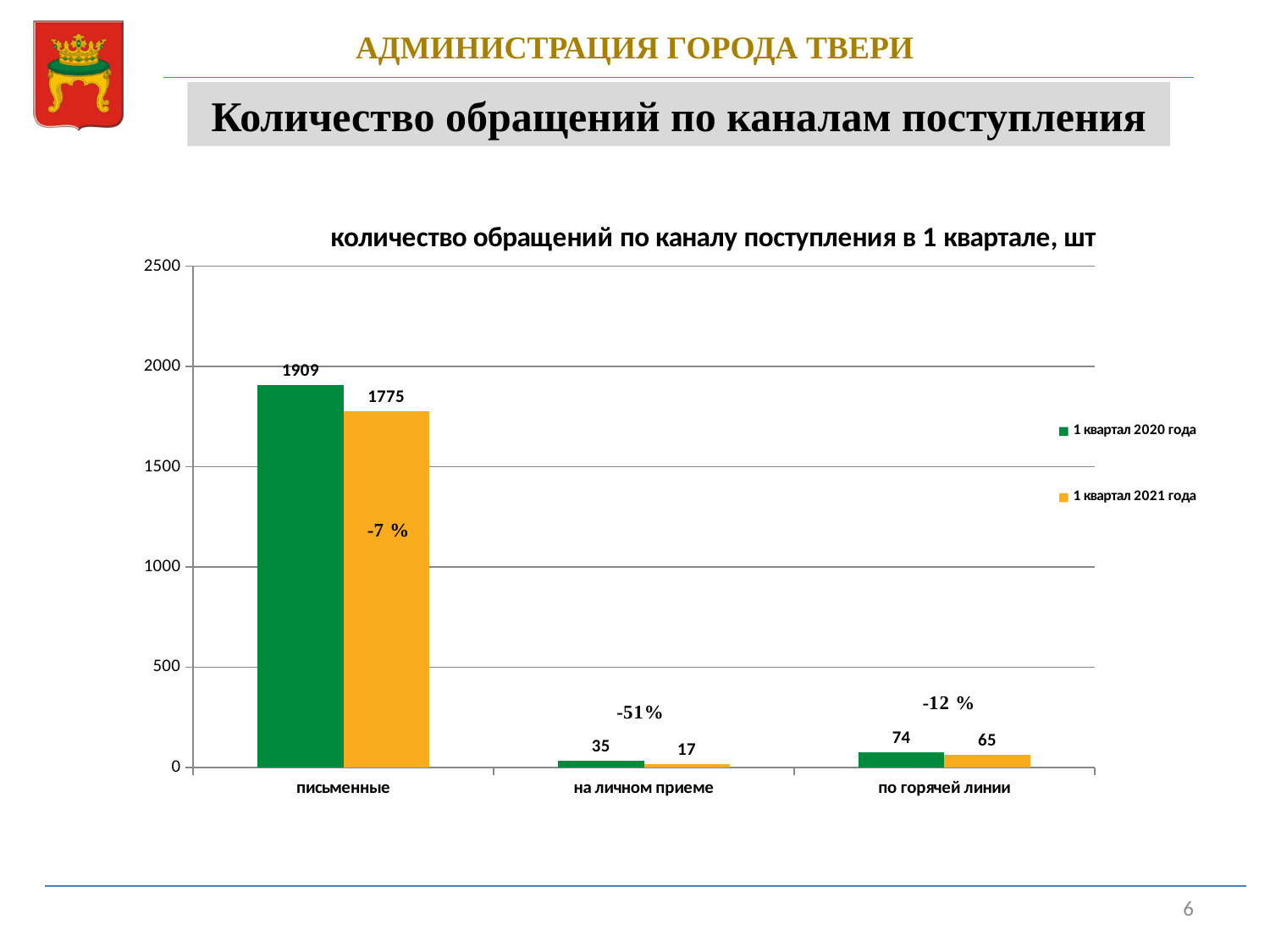
Which is larger: the value for по горячей линии in 1 квартал 2020 года or in 1 квартал 2021 года? 1 квартал 2020 года What is the value for письменные in 1 квартал 2021 года? 1775 What is the difference between the 1 квартал 2020 года and 1 квартал 2021 года values for письменные? 134 Which category has the lowest value in 1 квартал 2021 года? на личном приеме What is the value for по горячей линии in 1 квартал 2020 года? 74 What kind of chart is shown on the slide? bar chart What is the value for на личном приеме in 1 квартал 2021 года? 17 How many series does the legend list? 2 Is the value for письменные in 1 квартал 2021 года greater or less than 1500? greater What is the value for письменные in 1 квартал 2020 года? 1909 How many categories are shown on the x axis? 3 Which category has the highest value in 1 квартал 2020 года? письменные